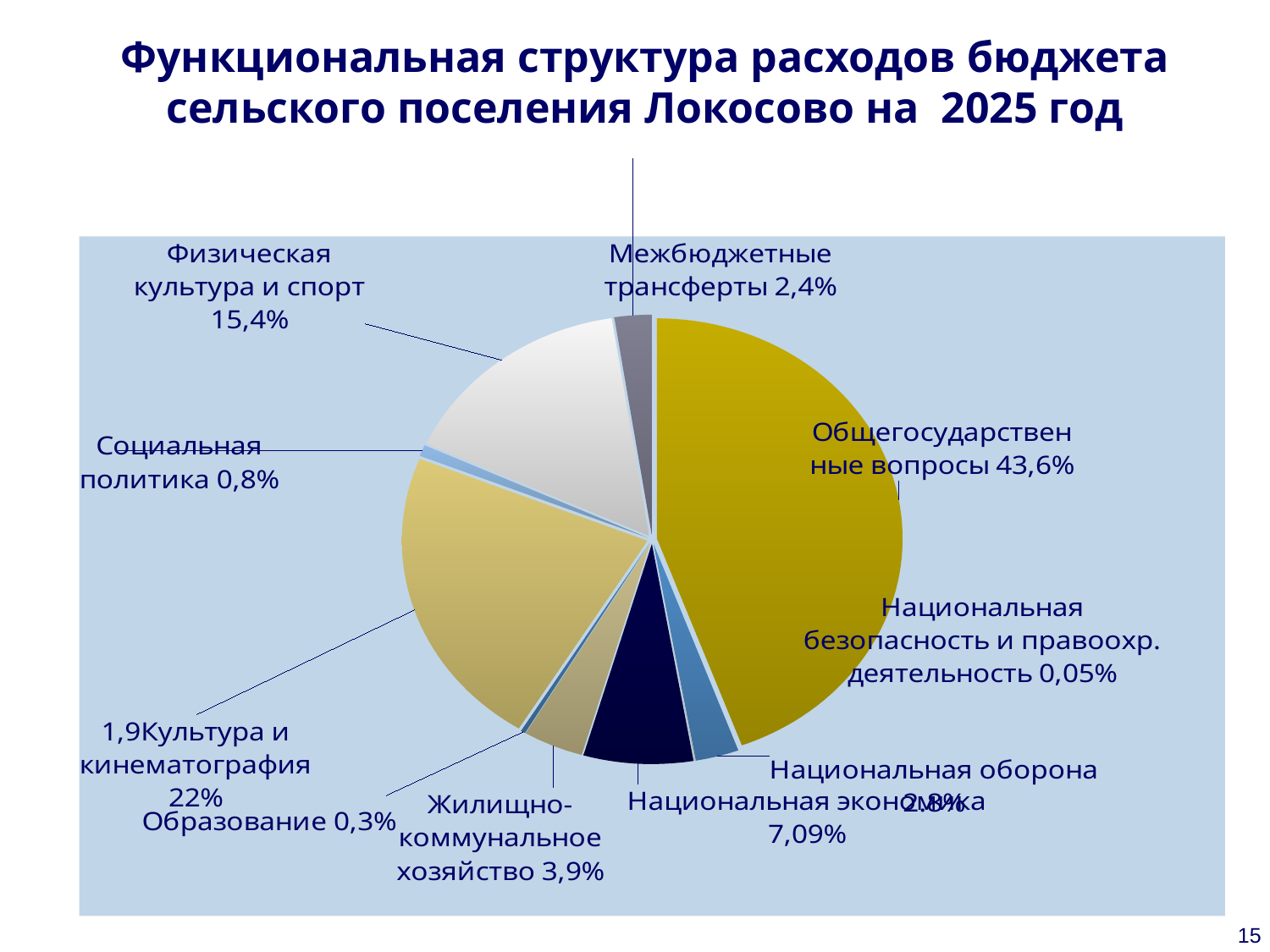
How many categories are shown in the pie chart? 10 What share is shown for Социальная политика? 0,8% What share of the budget expenditure goes to Общегосударственные вопросы? 43,6% What share is shown for Физическая культура и спорт? 15,4% What share is shown for Межбюджетные трансферты? 2,4% What share is shown for Жилищно-коммунальное хозяйство? 3,9% Which category has the largest share of the budget expenditure? Общегосударственные вопросы Which has the larger share: Физическая культура и спорт or Национальная экономика? Физическая культура и спорт What kind of chart is shown on the slide? pie chart By how many percentage points does the share of Общегосударственные вопросы exceed the share of Культура и кинематография? 21,6 Which category has the smallest share of the budget expenditure? Национальная безопасность и правоохр. деятельность What share is shown for Национальная экономика? 7,09%